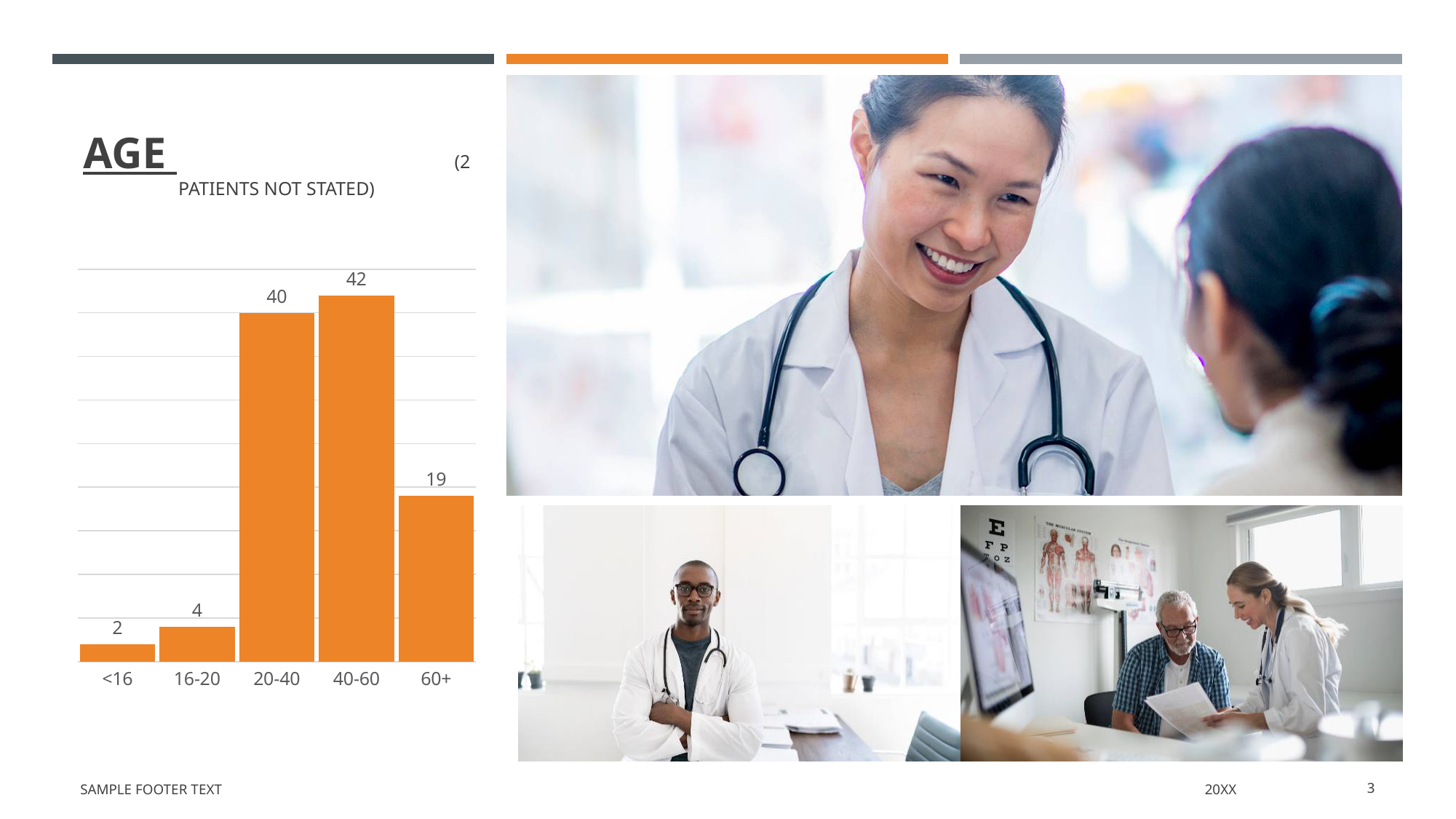
What is the value for the <16 age group? 2 Which age group has the lowest value? <16 What colour are the bars in the chart? orange What is the difference between the values for 40-60 and 60+? 23 Which is larger, the value for 16-20 or the value for 60+? 60+ What kind of chart is shown on the slide? bar chart What is the value for the 60+ age group? 19 How many age groups are shown on the x axis? 5 Which age group has the highest value? 40-60 What is the value for the 20-40 age group? 40 What is the difference between the values for 16-20 and <16? 2 What is the total of all the values shown in the chart? 107